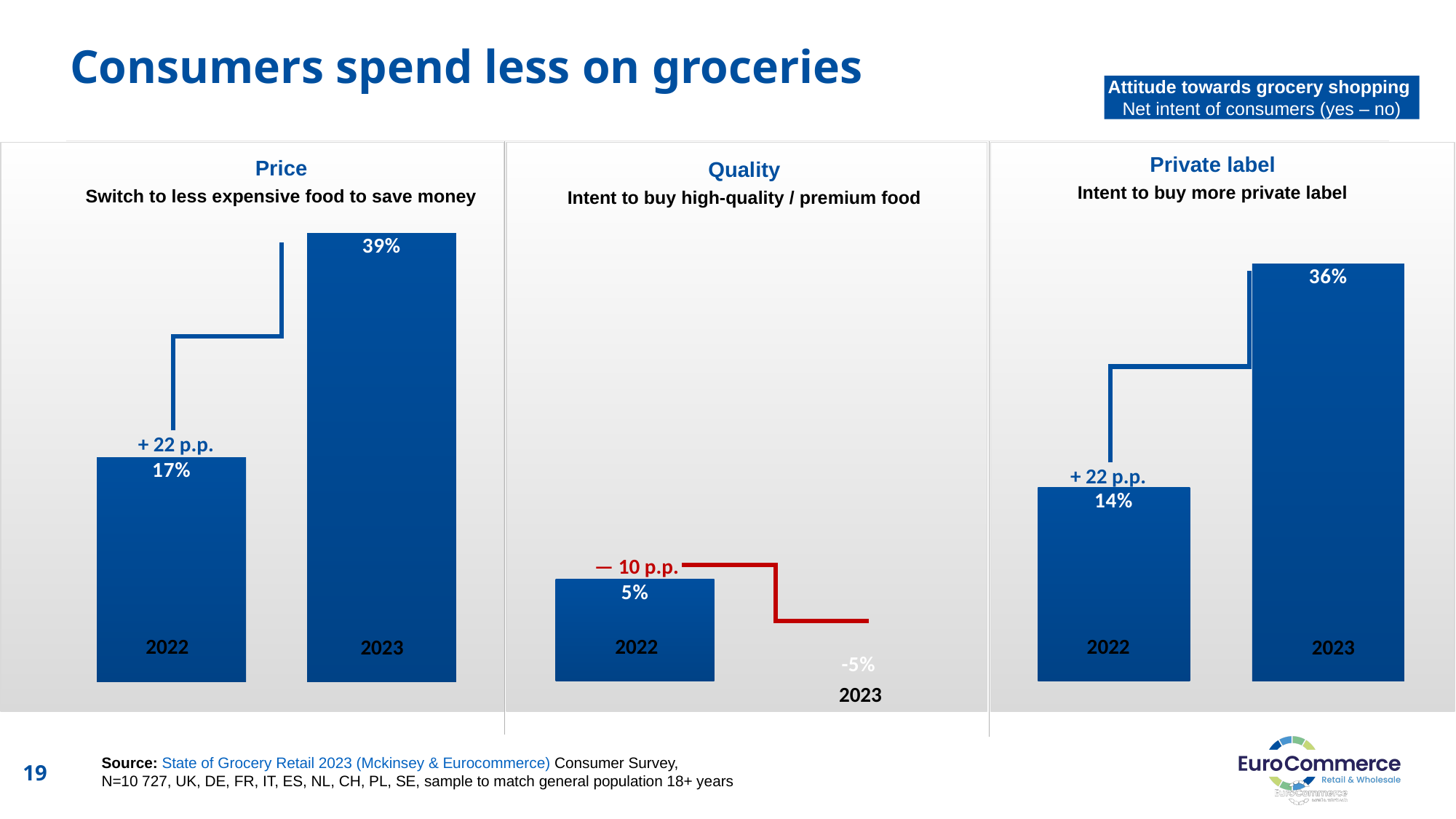
In the Price chart, what is the value for 2023? 39% In the Private label chart, what is the value for 2023? 36% In the Quality chart, what is the value for 2023? -5% In the Private label chart, which year has the higher value, 2022 or 2023? 2023 What kind of chart is the Price chart? bar chart In the Quality chart, by how many percentage points did the value change from 2022 to 2023? -10 p.p. In the Quality chart, does the value rise or fall from 2022 to 2023? fall How many charts are shown on the slide? 3 In the Price chart, what is the value for 2022? 17% In the Price chart, by how many percentage points did the value change from 2022 to 2023? + 22 p.p. In the Quality chart, what is the value for 2022? 5% In the Private label chart, what is the value for 2022? 14%